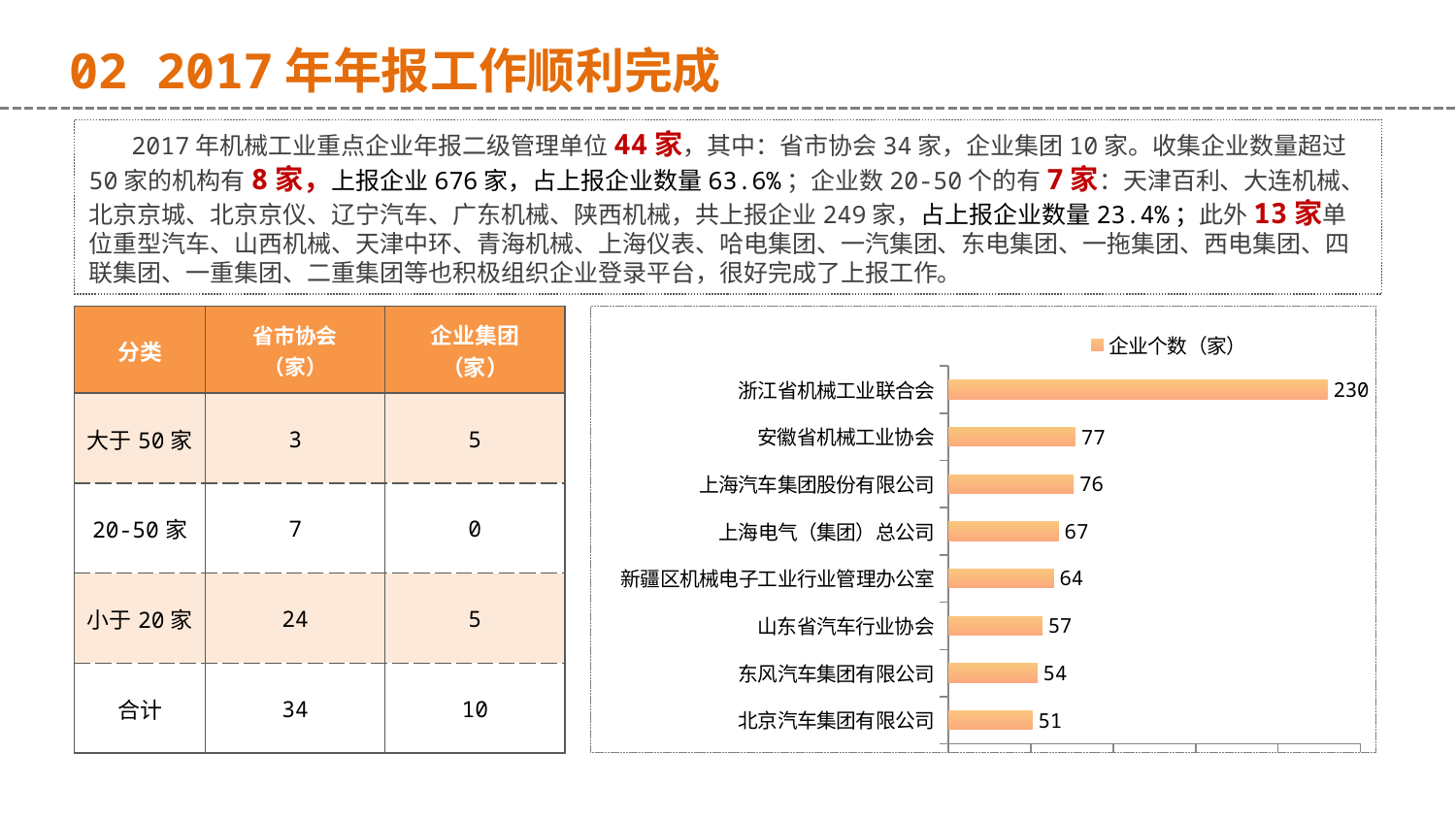
What is the difference between the values for 浙江省机械工业联合会 and 安徽省机械工业协会? 153 What is the difference between the values for 山东省汽车行业协会 and 东风汽车集团有限公司? 3 Which has a larger value, 上海汽车集团股份有限公司 or 东风汽车集团有限公司? 上海汽车集团股份有限公司 What is the value for 浙江省机械工业联合会 in the chart? 230 What type of chart is shown on the slide? bar chart Which category has the highest value in the chart? 浙江省机械工业联合会 What is the value for 北京汽车集团有限公司 in the chart? 51 How many categories are shown in the chart? 8 What is the value for 上海电气（集团）总公司 in the chart? 67 What is the value for 新疆区机械电子工业行业管理办公室 in the chart? 64 What is the legend entry shown in the chart? 企业个数（家） Which category has the lowest value in the chart? 北京汽车集团有限公司